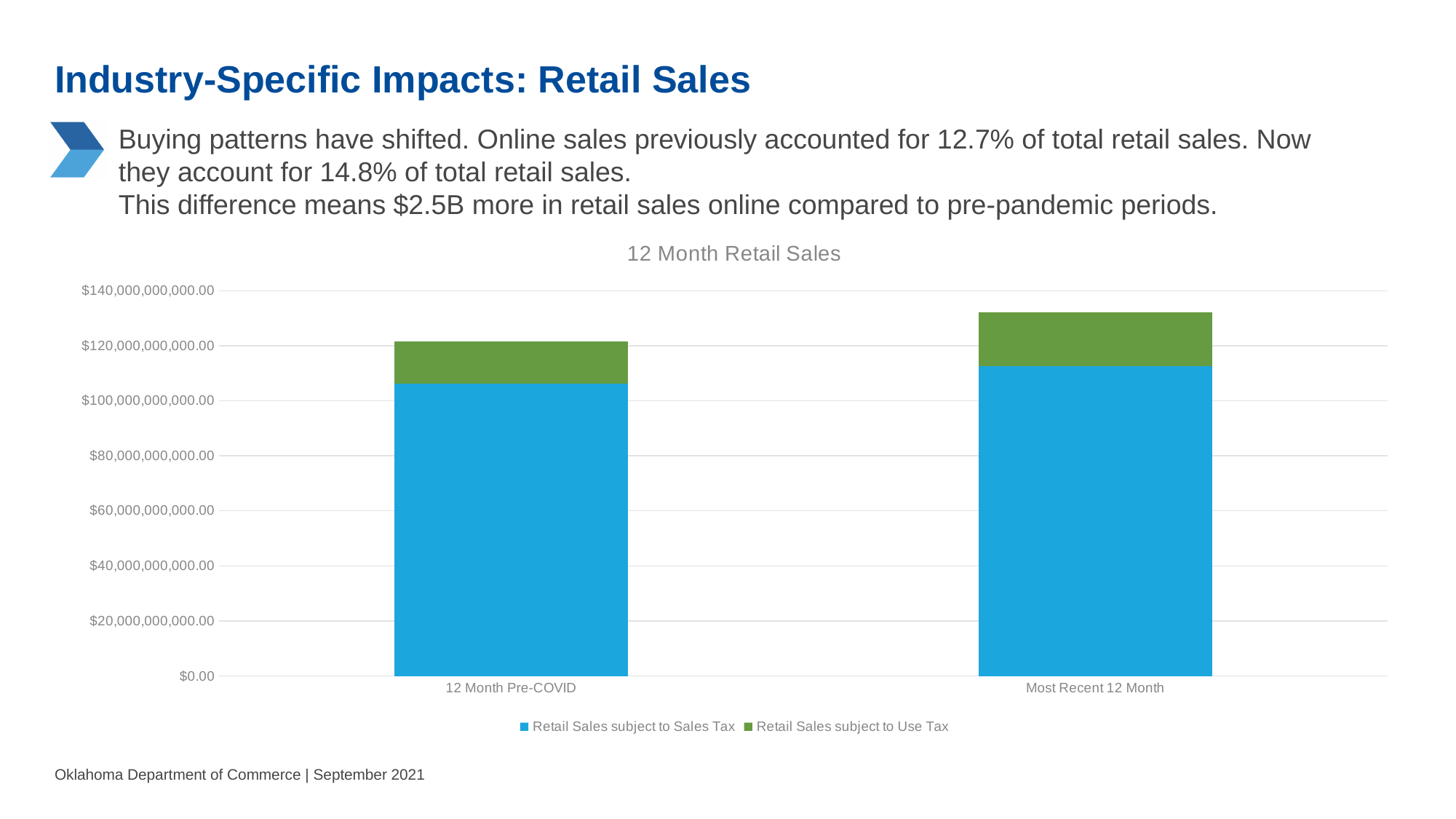
How many categories are shown on the x axis of the chart? 2 What is the title of the chart? 12 Month Retail Sales Is the total bar for Most Recent 12 Month larger or smaller than the total bar for 12 Month Pre-COVID? larger What kind of chart is shown on the slide? Stacked bar chart Is the total value for 12 Month Pre-COVID greater or less than $140,000,000,000.00? less Which series is shown in green in the chart? Retail Sales subject to Use Tax How many series does the chart's legend list? 2 Which category has the higher total stacked bar? Most Recent 12 Month Do the total retail sales rise or fall from 12 Month Pre-COVID to Most Recent 12 Month? rise Which category has the lower total stacked bar? 12 Month Pre-COVID Is the total value for Most Recent 12 Month greater or less than $120,000,000,000.00? greater Is the Retail Sales subject to Sales Tax value for 12 Month Pre-COVID greater or less than $100,000,000,000.00? greater